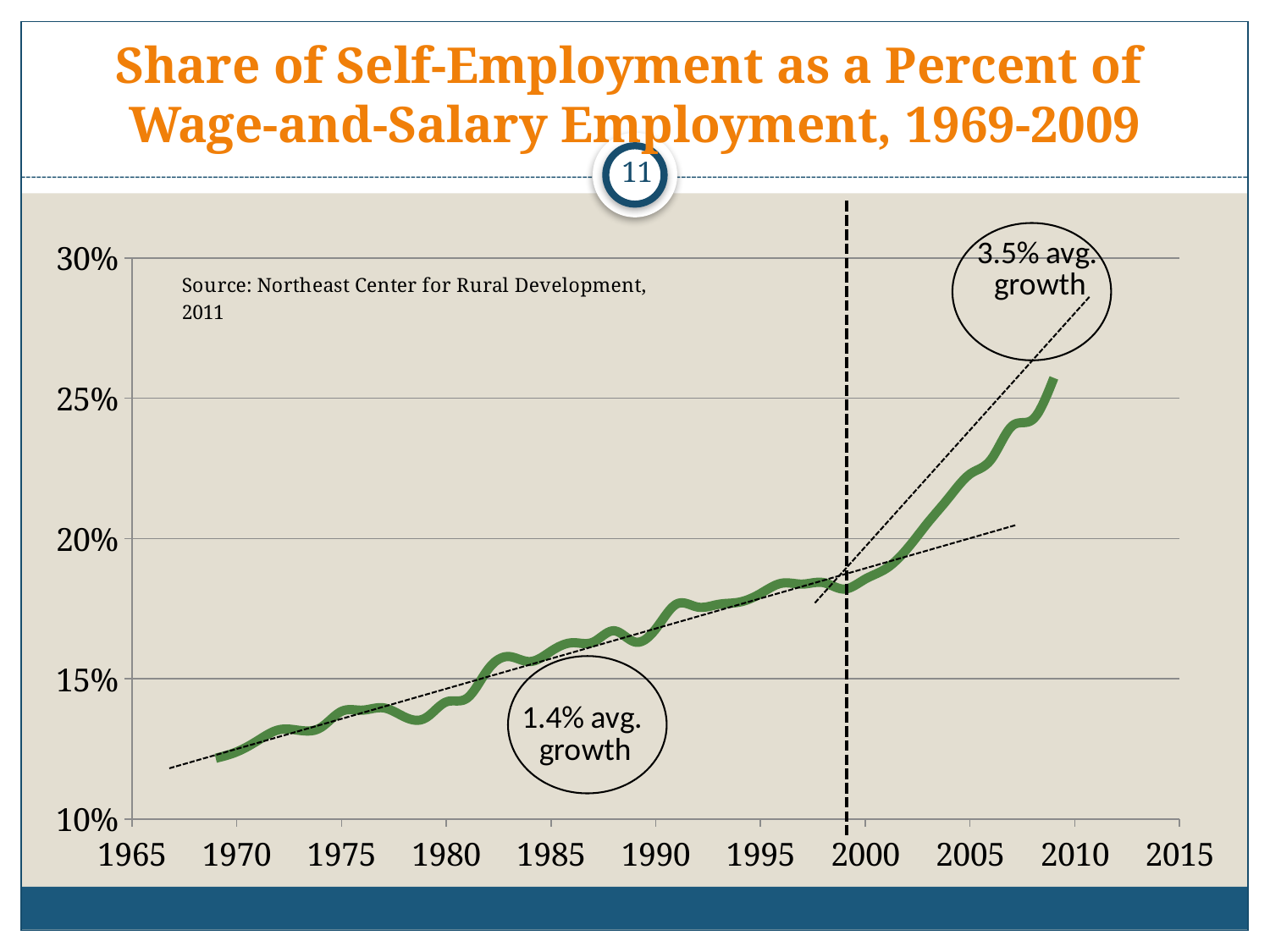
Is the value for 1980 greater or less than 15%? less Is the value for 2000 greater or less than 20%? less Which is larger, the value for 1985 or the value for 2005? 2005 What average growth rate is annotated for the later period of the chart? 3.5% avg. growth What is the title of the chart? Share of Self-Employment as a Percent of Wage-and-Salary Employment, 1969-2009 Does the share of self-employment generally rise or fall from 1969 to 2009? rise Is the value for 1970 greater or less than 15%? less What average growth rate is annotated for the earlier period of the chart? 1.4% avg. growth In which year does the line reach its highest value? 2009 What kind of chart is shown on the slide? line chart